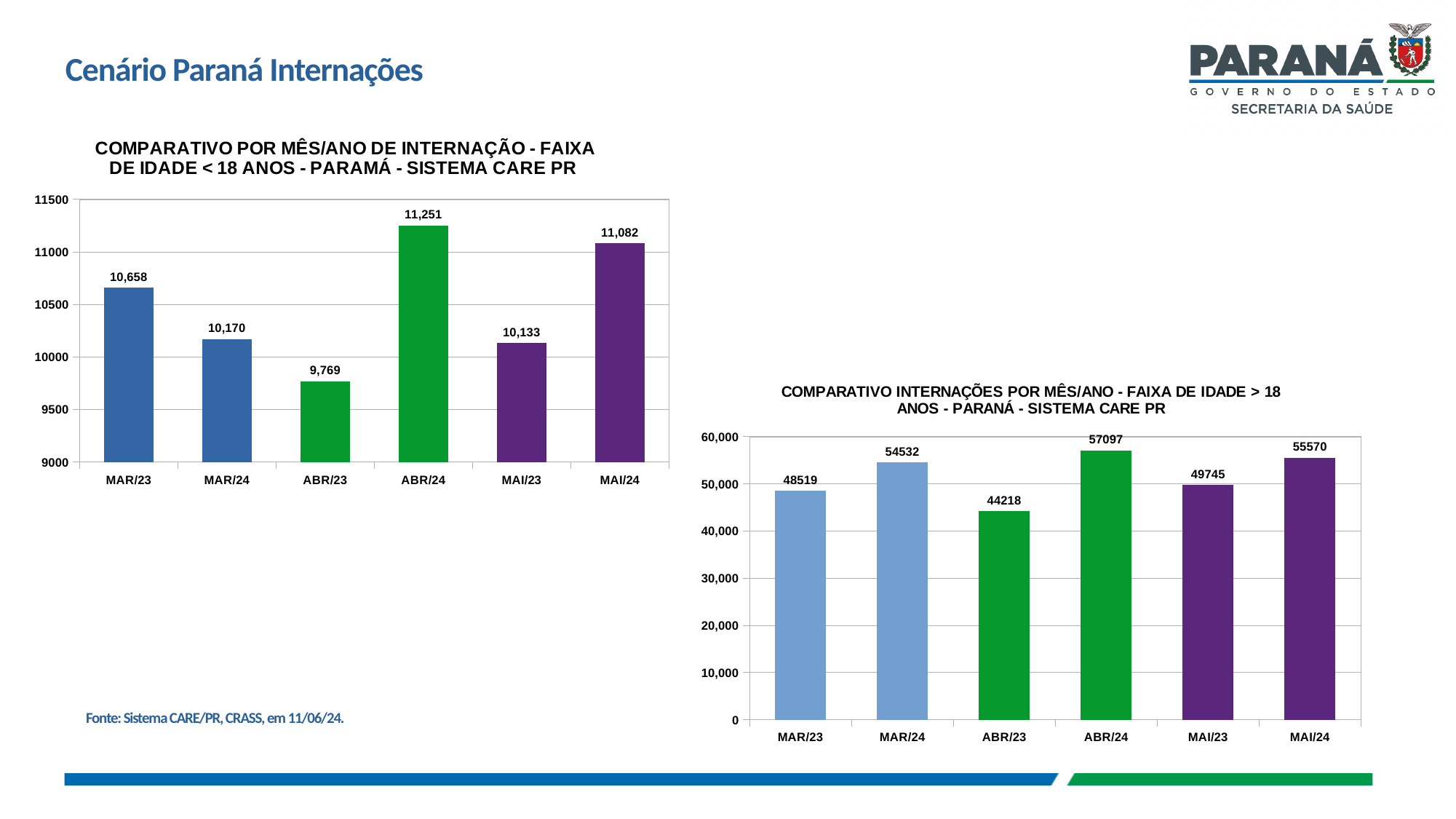
In the right chart (faixa de idade > 18 anos), what is the value for MAR/24? 54532 In the right chart (faixa de idade > 18 anos), is the value for MAI/23 greater or less than 50,000? less In the left chart (faixa de idade < 18 anos), what is the difference between MAR/23 and MAR/24? 488 In the left chart (faixa de idade < 18 anos), what is the value for ABR/24? 11,251 In the left chart (faixa de idade < 18 anos), which is larger, MAI/24 or MAI/23? MAI/24 What is the source cited at the bottom of the slide? Sistema CARE/PR, CRASS, em 11/06/24 What kind of chart is the right chart (faixa de idade > 18 anos)? Bar chart In the right chart (faixa de idade > 18 anos), which month/year has the highest value? ABR/24 In the left chart (faixa de idade < 18 anos), what is the value for MAI/23? 10,133 In the left chart (faixa de idade < 18 anos), how many bars are plotted? 6 In the right chart (faixa de idade > 18 anos), what is the difference between ABR/24 and ABR/23? 12879 In the left chart (faixa de idade < 18 anos), which month/year has the lowest value? ABR/23